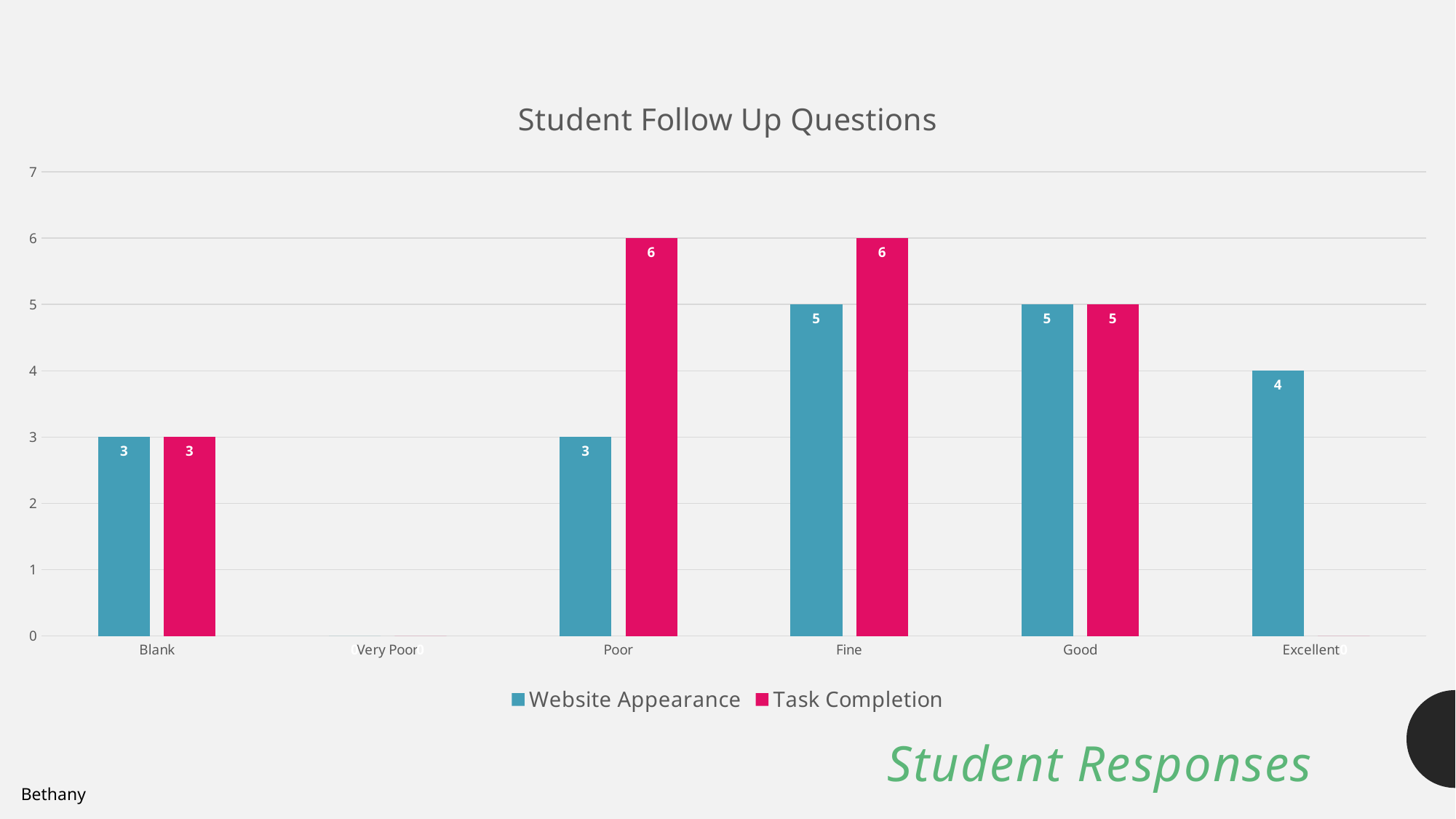
What is the Website Appearance value for the Fine category? 5 In the Poor category, how much larger is the Task Completion value than the Website Appearance value? 3 What kind of chart is shown on the slide? Bar chart What is the Task Completion value for the Good category? 5 What is the Website Appearance value for the Blank category? 3 What is the Task Completion value for the Poor category? 6 What is the difference between the Task Completion value for Fine and the Website Appearance value for Excellent? 2 How many categories are shown on the x axis of the chart? 6 In the Fine category, which series has the larger value, Website Appearance or Task Completion? Task Completion How many series does the legend list? 2 What is the Website Appearance value for the Excellent category? 4 What is the title of the chart? Student Follow Up Questions